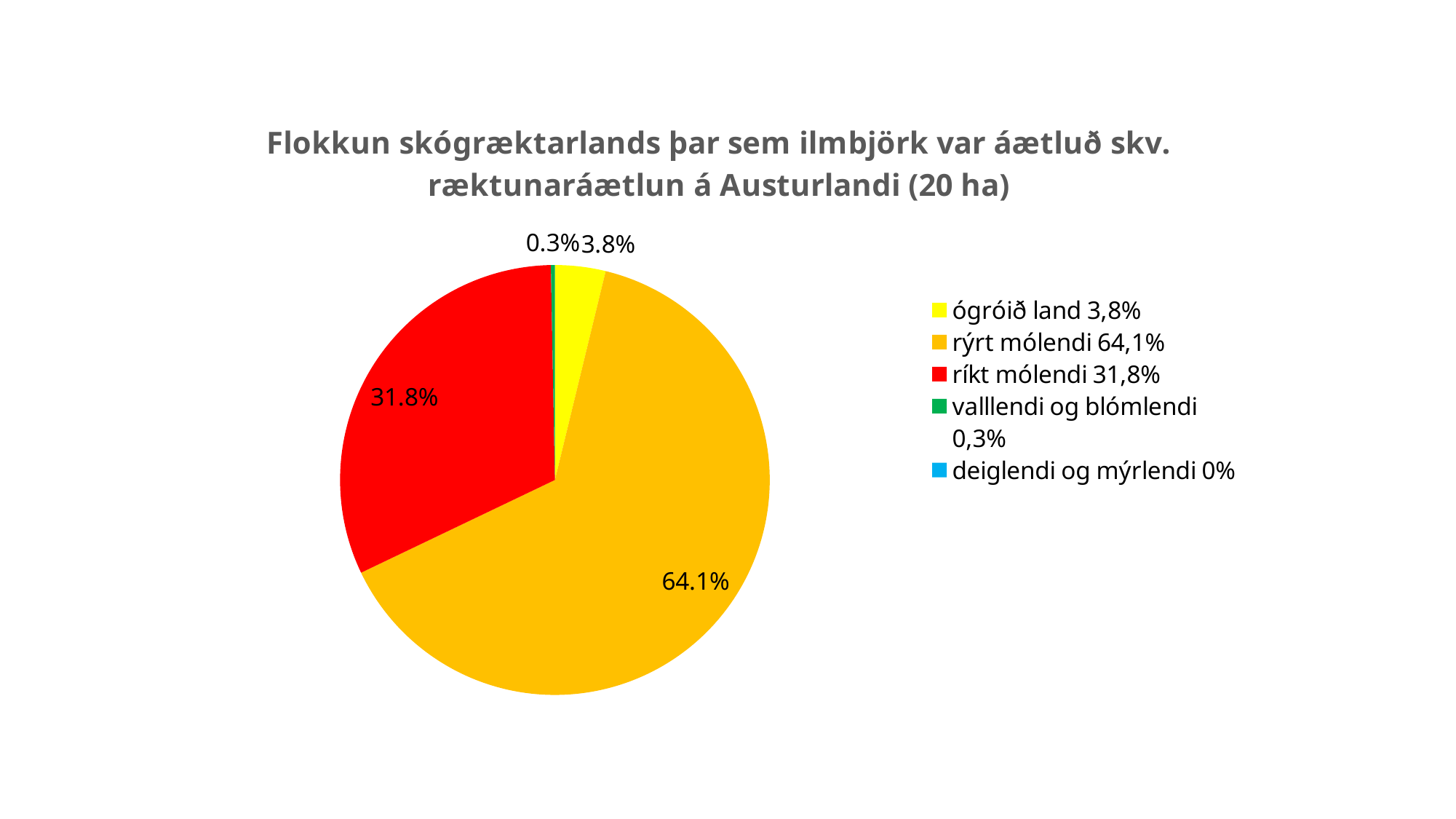
What type of chart is shown on the slide? pie chart Which category has the largest slice of the pie? rýrt mólendi What is the value shown for ríkt mólendi? 31.8% What is the value shown for valllendi og blómlendi? 0.3% How many categories does the legend list? 5 What colour is the slice for ríkt mólendi? red What is the value shown for ógróið land? 3.8% What is the value shown in the legend for deiglendi og mýrlendi? 0% What share of the pie does rýrt mólendi have? 64.1% What is the difference between the shares of rýrt mólendi and ríkt mólendi? 32.3% Which is larger, the share of ógróið land or the share of ríkt mólendi? ríkt mólendi Which category has the smallest share according to the legend? deiglendi og mýrlendi